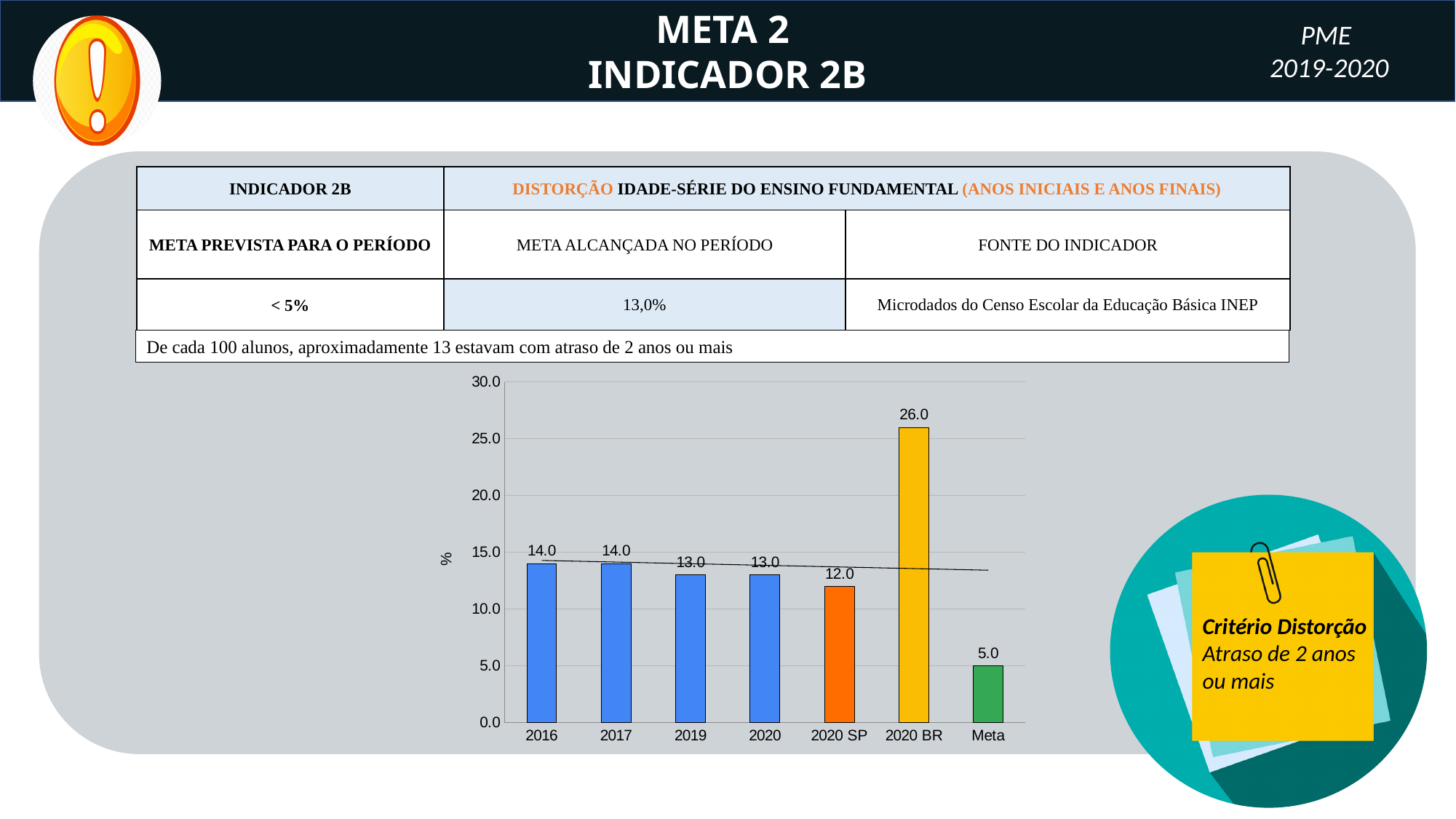
What is the difference between the values for 2020 BR and 2020? 13.0 Which category has the highest value in the chart? 2020 BR What is the value for 2016 in the chart? 14.0 What is the difference between the values for 2016 and 2019? 1.0 What is the label on the vertical axis of the chart? % Which category has the lowest value in the chart? Meta How many bars are shown in the chart? 7 What is the value for 2020 BR in the chart? 26.0 What is the value for 2020 SP in the chart? 12.0 What kind of chart is shown on the slide? bar chart Which is larger, the value for 2020 SP or the value for 2020 BR? 2020 BR What is the value for Meta in the chart? 5.0